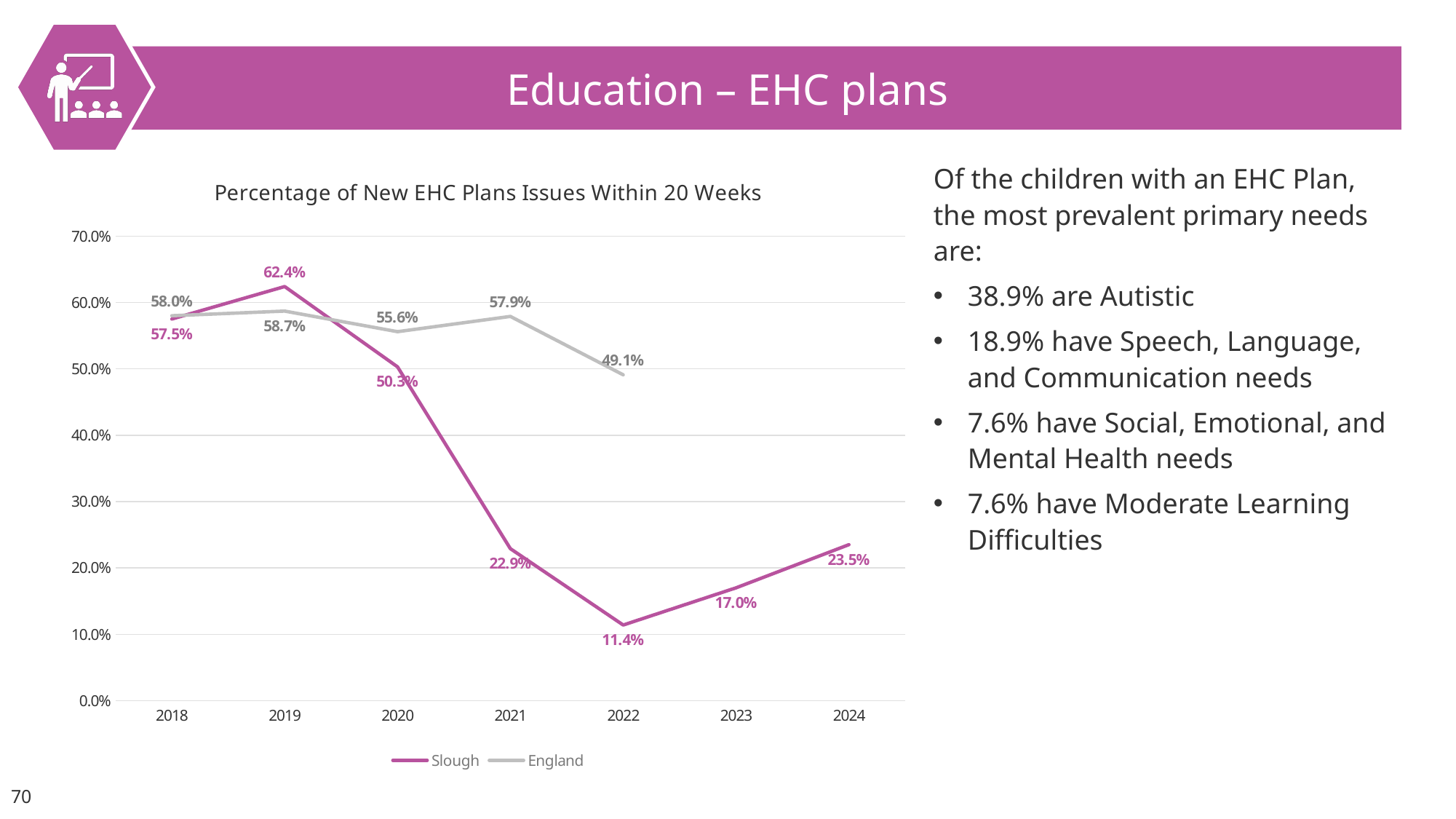
In which year was the Slough value highest? 2019 Did the Slough value rise or fall between 2022 and 2024? rise What was the value for England in 2022? 49.1% How many series does the legend list? 2 What is the difference between the England and Slough values in 2021? 35.0% In which year was the Slough value lowest? 2022 Which was larger in 2019, the Slough value or the England value? Slough What was the percentage of new EHC plans issued within 20 weeks for Slough in 2019? 62.4% What was the value for Slough in 2022? 11.4% What type of chart is shown on the slide? line chart How many years are shown on the x axis? 7 Is the Slough value for 2024 greater or less than 20.0%? greater